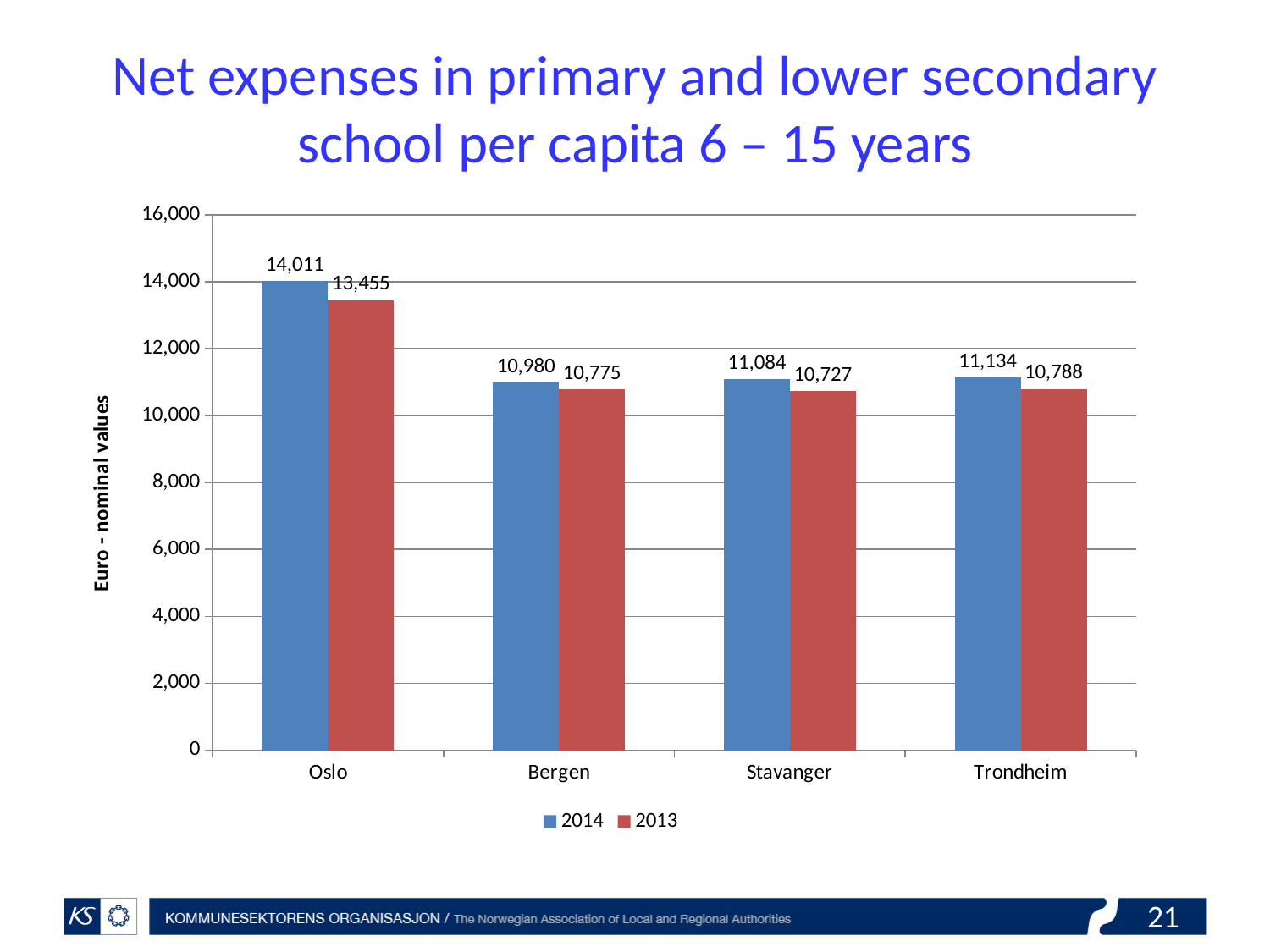
How many cities are shown on the x axis? 4 What is the 2013 value for Stavanger? 10,727 Which city has the highest 2014 value? Oslo Is the 2013 value for Oslo greater or less than 12,000? greater What is the 2014 value for Oslo? 14,011 Which is larger, the 2014 value for Bergen or the 2014 value for Stavanger? Stavanger What is the difference between the 2014 values for Trondheim and Bergen? 154 What is the 2014 value for Trondheim? 11,134 What kind of chart is shown? bar chart Which city has the lowest 2013 value? Stavanger What is the difference between the 2014 and 2013 values for Oslo? 556 How many series does the legend list? 2